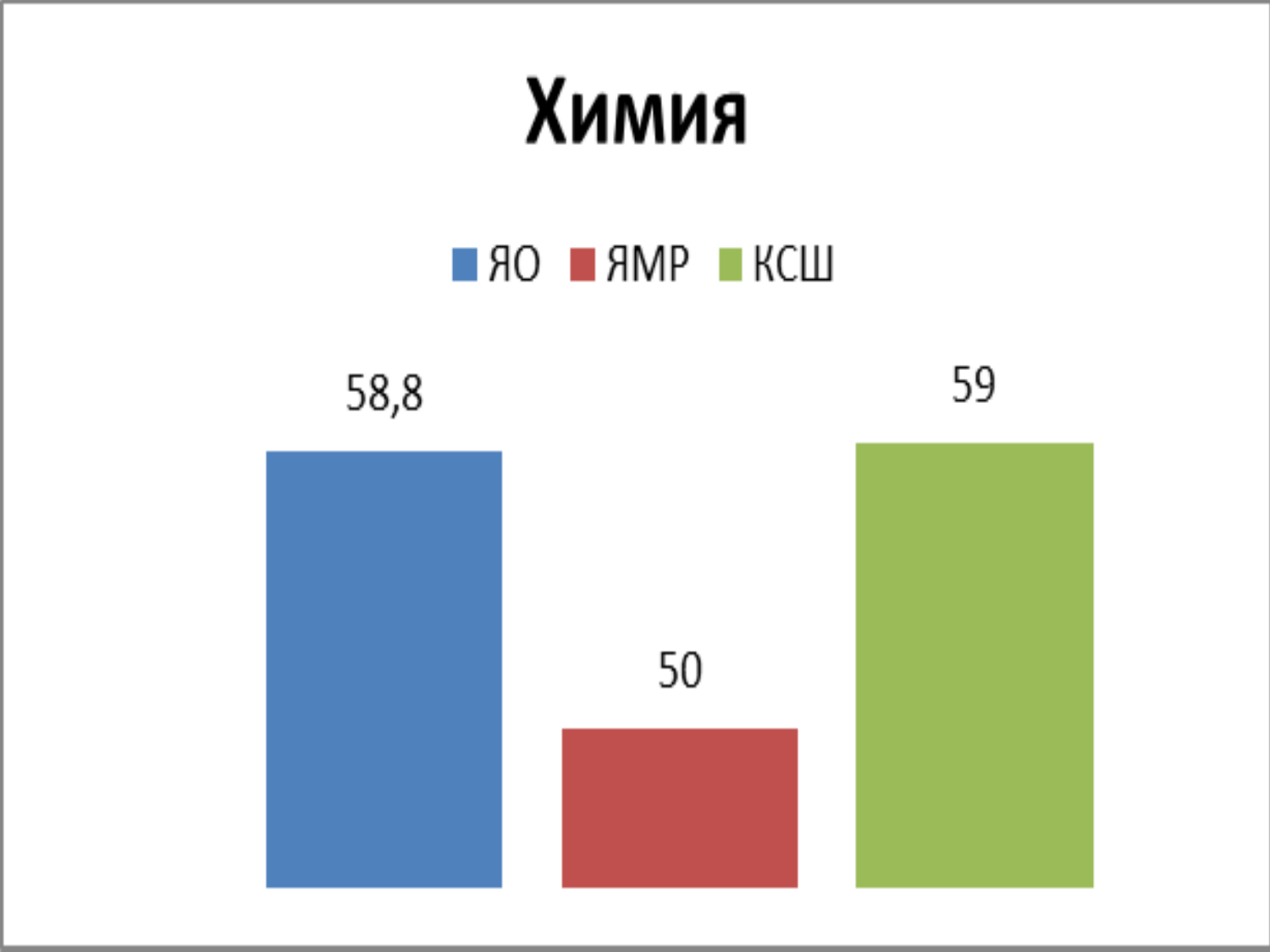
What is the value for ЯО in the Химия chart? 58,8 Which category has the highest value in the Химия chart? КСШ How many bars are shown in the Химия chart? 3 What kind of chart is shown on the slide? bar chart Which is larger, the value for ЯО or the value for ЯМР? ЯО What is the value for ЯМР in the Химия chart? 50 What is the value for КСШ in the Химия chart? 59 What is the title of the chart? Химия How many entries does the legend list? 3 What is the difference between the values for ЯО and ЯМР? 8,8 Which category has the lowest value in the Химия chart? ЯМР What is the difference between the values for КСШ and ЯМР? 9